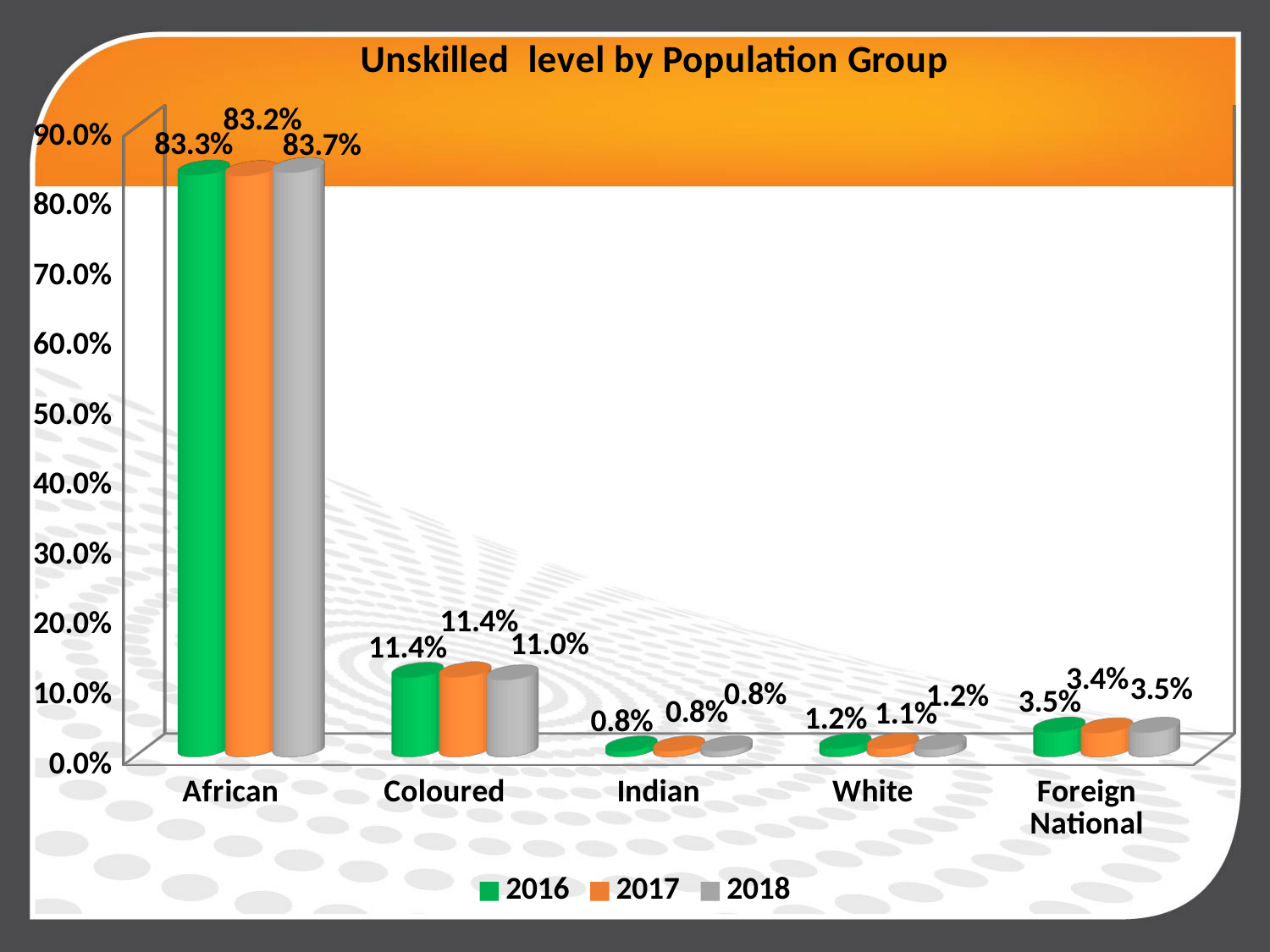
Which population group has the lowest value in 2016? Indian What is the value for African in 2016? 83.3% What is the value for Foreign National in 2017? 3.4% Which is larger, the Foreign National value in 2016 or the White value in 2016? Foreign National Is the value for Coloured in 2016 greater or less than 20.0%? less What is the value for Coloured in 2018? 11.0% What is the value for White in 2017? 1.1% How many population groups are shown on the x axis? 5 Which population group has the highest value in 2018? African How many series does the legend list? 3 What kind of chart is shown on the slide? bar chart What is the difference between the African and Coloured values in 2017? 71.8%